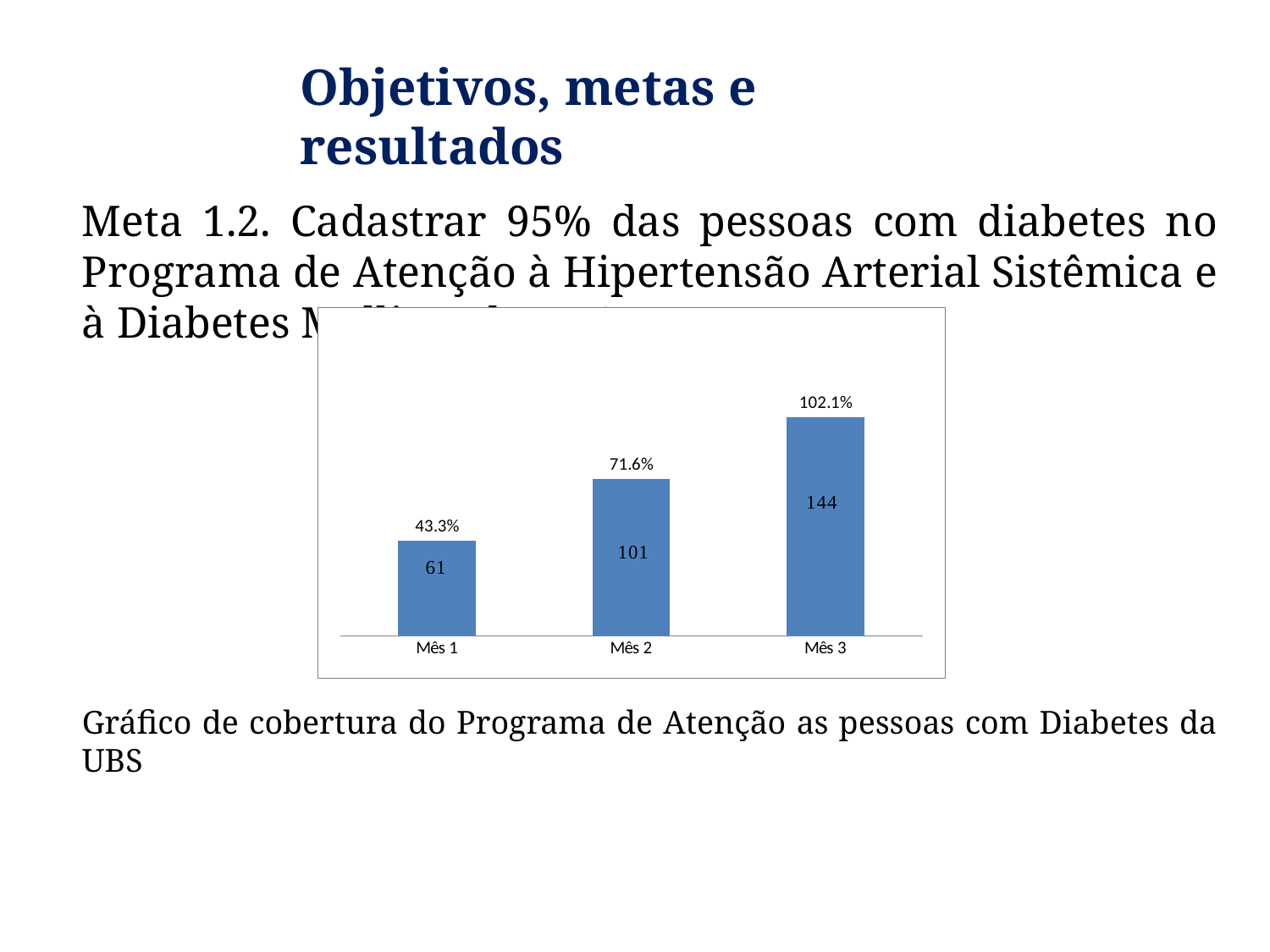
Which is larger, the value for Mês 2 or the value for Mês 1? Mês 2 What is the difference between the numbers inside the bars for Mês 3 and Mês 1? 83 What percentage is shown above the bar for Mês 1? 43.3% Which month has the highest bar? Mês 3 Which month has the lowest bar? Mês 1 Do the values rise or fall from Mês 1 to Mês 3? rise What is the difference in percentage points between Mês 2 and Mês 1? 28.3 What percentage is shown above the bar for Mês 2? 71.6% How many bars are shown in the chart? 3 What number is printed inside the bar for Mês 1? 61 What percentage is shown above the bar for Mês 3? 102.1% What number is printed inside the bar for Mês 3? 144